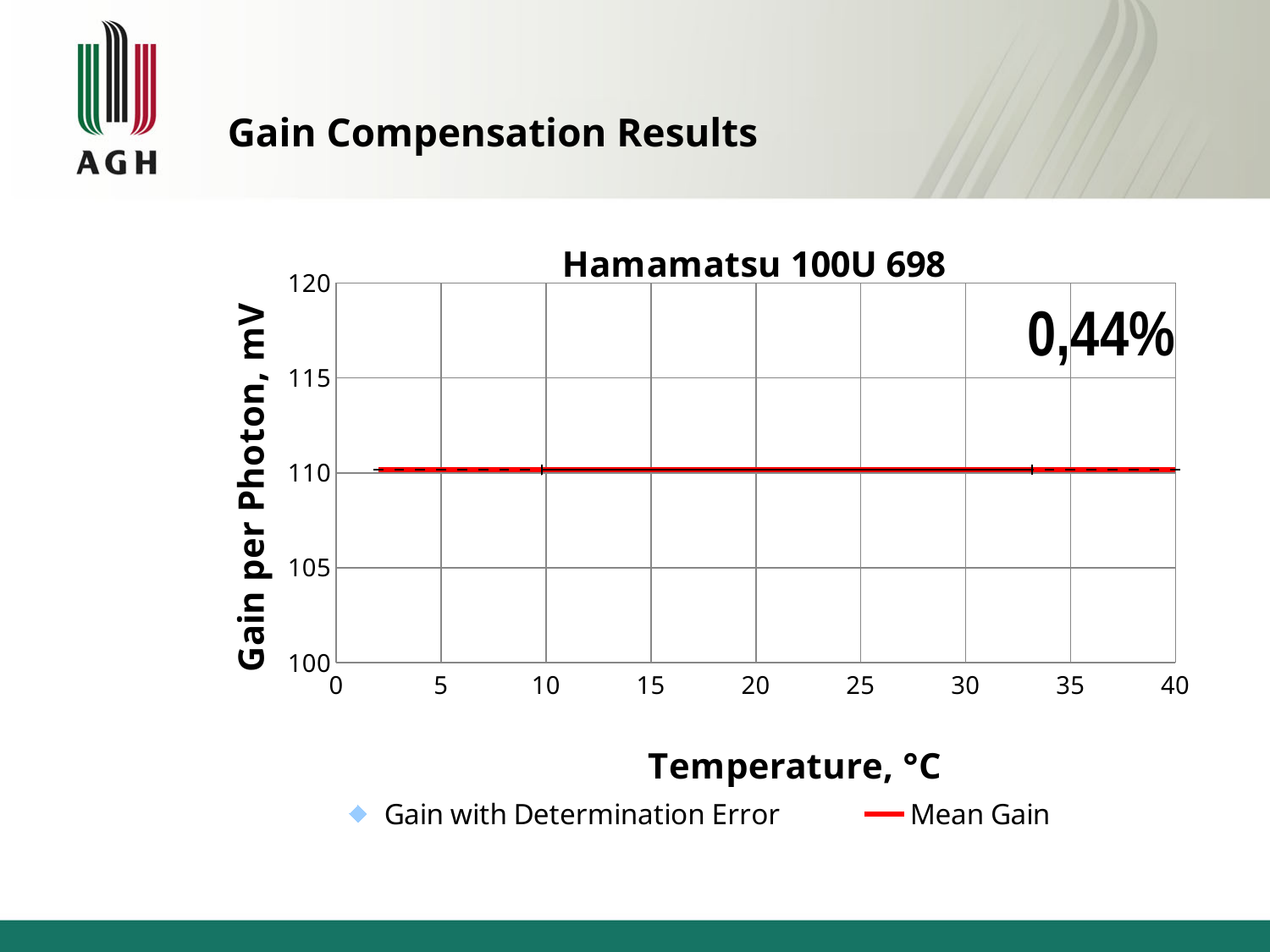
What is the label of the x axis of the chart? Temperature, °C What percentage value is annotated on the chart? 0,44% Is the Mean Gain at 30 °C greater or less than 115? less Does the gain rise, fall, or stay roughly constant as temperature increases from 0 to 40 °C? stays roughly constant What colour is the Mean Gain line in the chart? red What is the title of the chart? Hamamatsu 100U 698 What is the maximum value shown on the y axis of the chart? 120 What are the two series named in the chart legend? Gain with Determination Error; Mean Gain Is the Mean Gain at 20 °C greater or less than 105? greater What is the label of the y axis of the chart? Gain per Photon, mV What is the maximum temperature shown on the x axis of the chart? 40 How many series does the chart legend list? 2